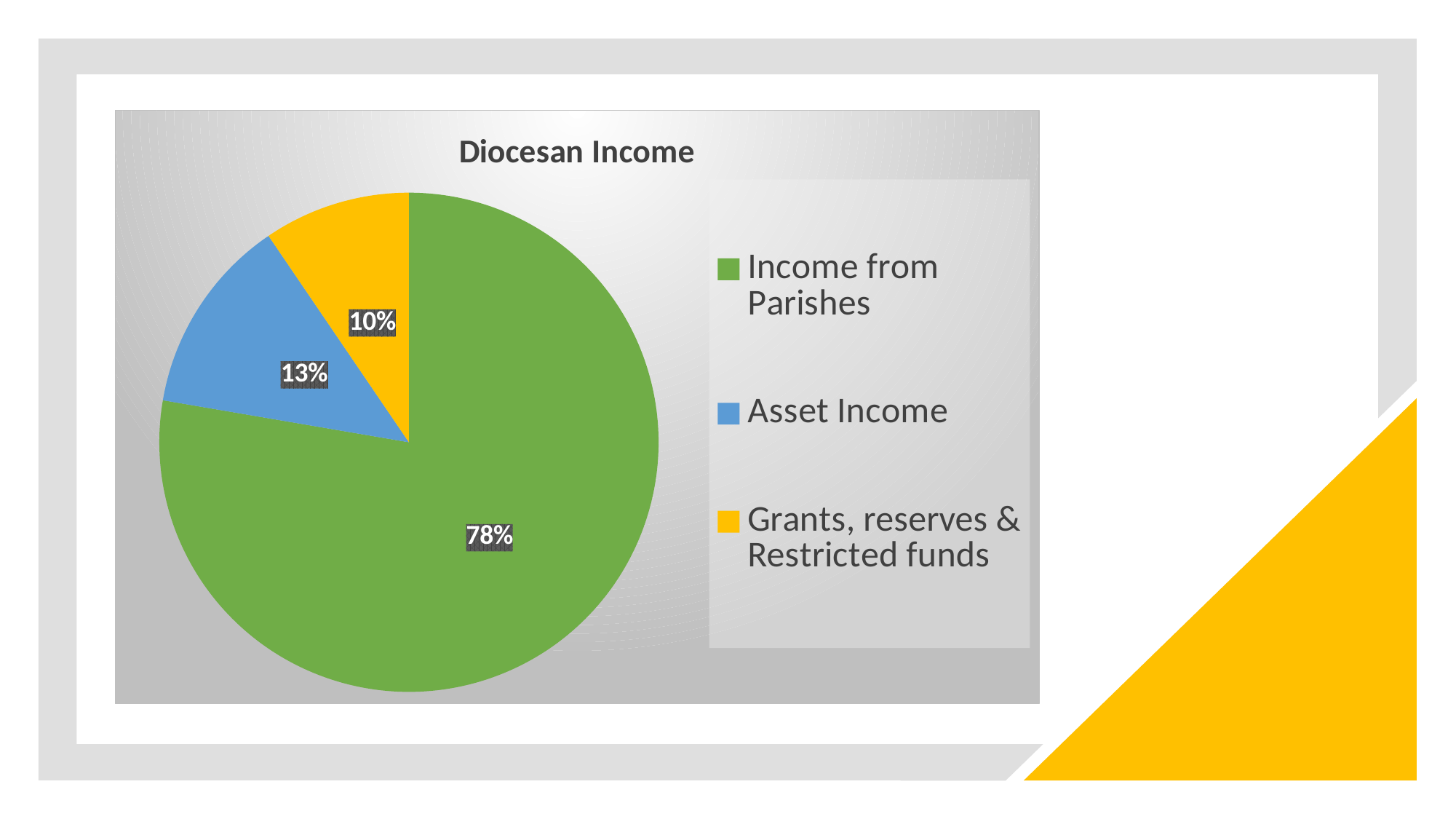
What share of Diocesan Income comes from Grants, reserves & Restricted funds? 10% What share of Diocesan Income is Asset Income? 13% What share of Diocesan Income comes from Income from Parishes? 78% What is the title of the chart? Diocesan Income What kind of chart is shown on the slide? pie chart What colour represents Asset Income in the pie chart? blue Which category has the largest share of Diocesan Income? Income from Parishes Which category has the smallest share of Diocesan Income? Grants, reserves & Restricted funds How many entries does the legend list? 3 How many categories does the pie chart show? 3 What is the difference in percentage points between Income from Parishes and Asset Income? 65 Which is larger, Asset Income or Grants, reserves & Restricted funds? Asset Income